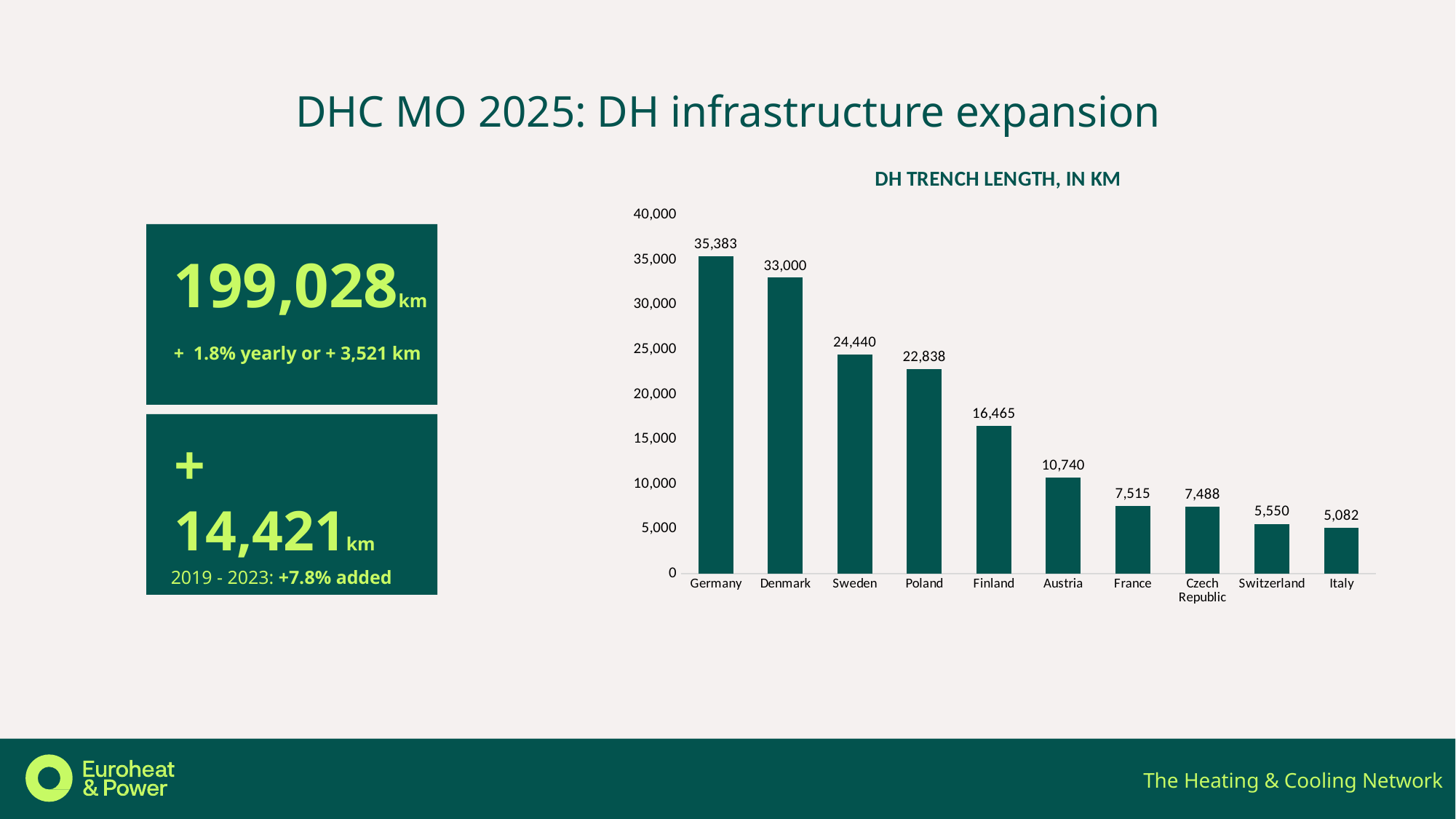
What is the DH trench length for Czech Republic? 7,488 What is the DH trench length for Germany? 35,383 Which country has the lowest DH trench length? Italy Which has a larger DH trench length, Austria or France? Austria What kind of chart is shown on the slide? Bar chart How many countries are shown in the chart? 10 What is the DH trench length for Poland? 22,838 Is the value for Finland greater or less than 15,000? greater Which country has the highest DH trench length? Germany What is the title of the chart? DH TRENCH LENGTH, IN KM What is the difference in DH trench length between Sweden and Finland? 7,975 What is the difference in DH trench length between Germany and Denmark? 2,383